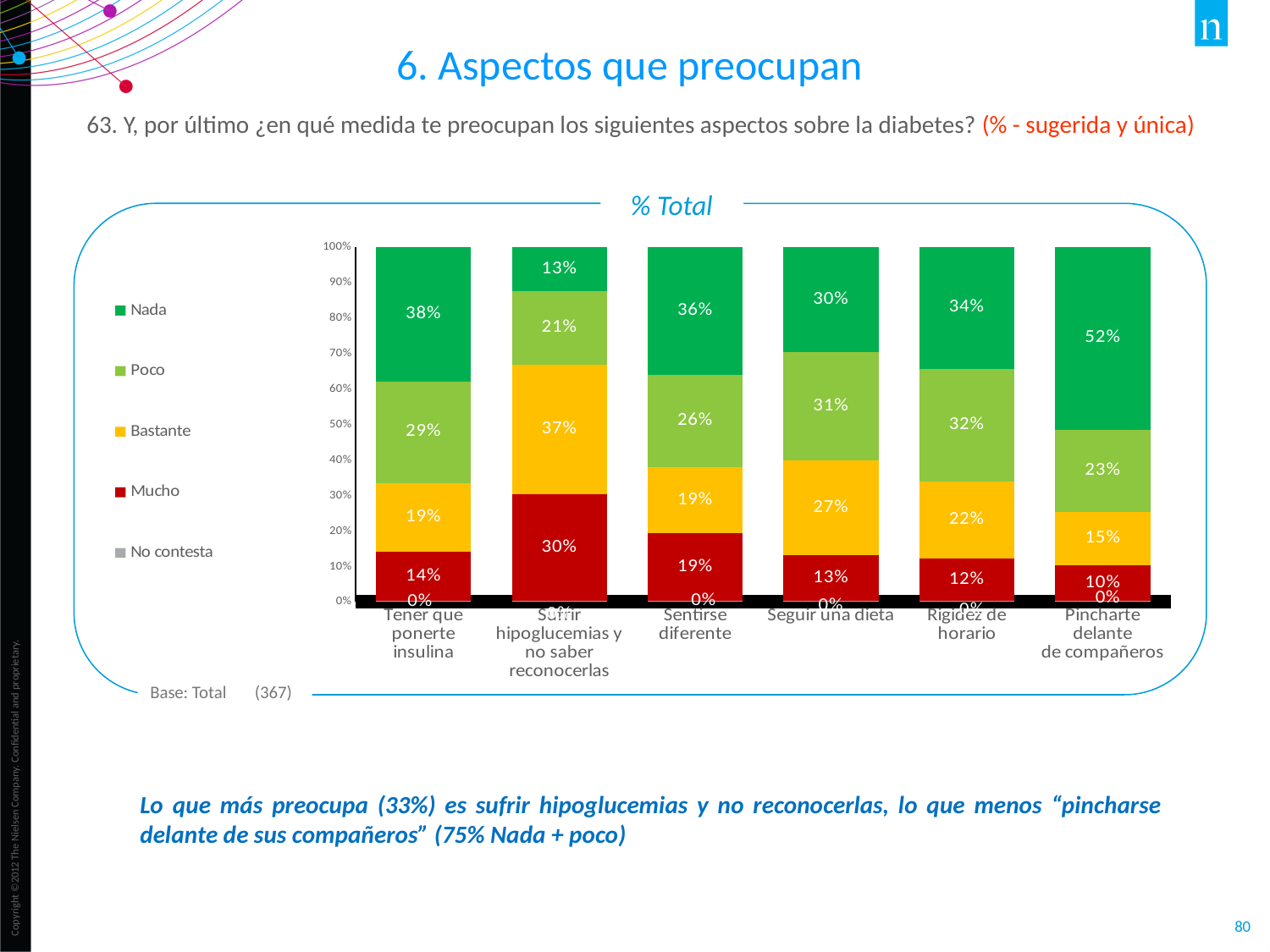
What is the difference between the 'Nada' value for 'Tener que ponerte insulina' and the 'Nada' value for 'Sufrir hipoglucemias y no saber reconocerlas'? 25% What type of chart is shown on the slide? stacked bar chart What is the 'Bastante' value for 'Seguir una dieta'? 27% What is the 'Nada' value for 'Pincharte delante de compañeros'? 52% Which category has the highest 'Nada' value? Pincharte delante de compañeros How many series does the legend of the chart list? 5 How many categories (aspects) are shown on the x axis of the chart? 6 Which category has the lowest 'Mucho' value? Pincharte delante de compañeros What is the 'Mucho' value for 'Sufrir hipoglucemias y no saber reconocerlas'? 30% What is the title shown above the chart? % Total Which is larger: the 'Bastante' value for 'Sufrir hipoglucemias y no saber reconocerlas' or the 'Bastante' value for 'Sentirse diferente'? Sufrir hipoglucemias y no saber reconocerlas What is the 'Poco' value for 'Rigidez de horario'? 32%